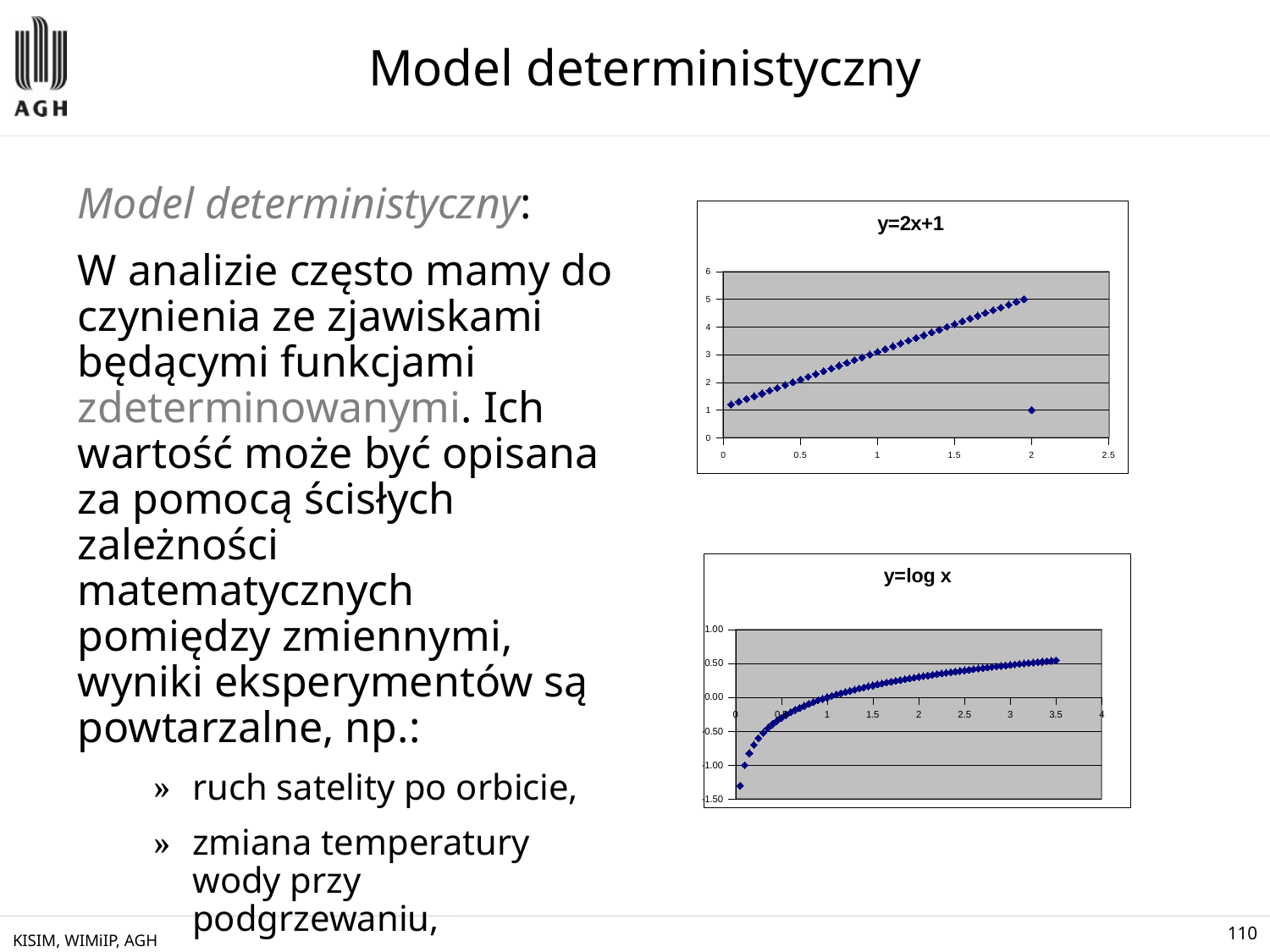
In the chart titled "y=log x", is the value at x = 0.5 greater or less than 0.00? less In the chart titled "y=2x+1", is the value at x = 1 greater or less than 2? greater How many charts are shown on the slide? 2 What is the title of the lower chart on the slide? y=log x In the chart titled "y=2x+1", do the plotted values rise or fall as x increases? rise What kind of chart is the chart titled "y=2x+1"? scatter chart In the chart titled "y=log x", do the plotted values rise or fall as x increases? rise In the chart titled "y=log x", is the value at x = 2 greater or less than 0.00? greater What is the title of the upper chart on the slide? y=2x+1 What kind of chart is the chart titled "y=log x"? scatter chart